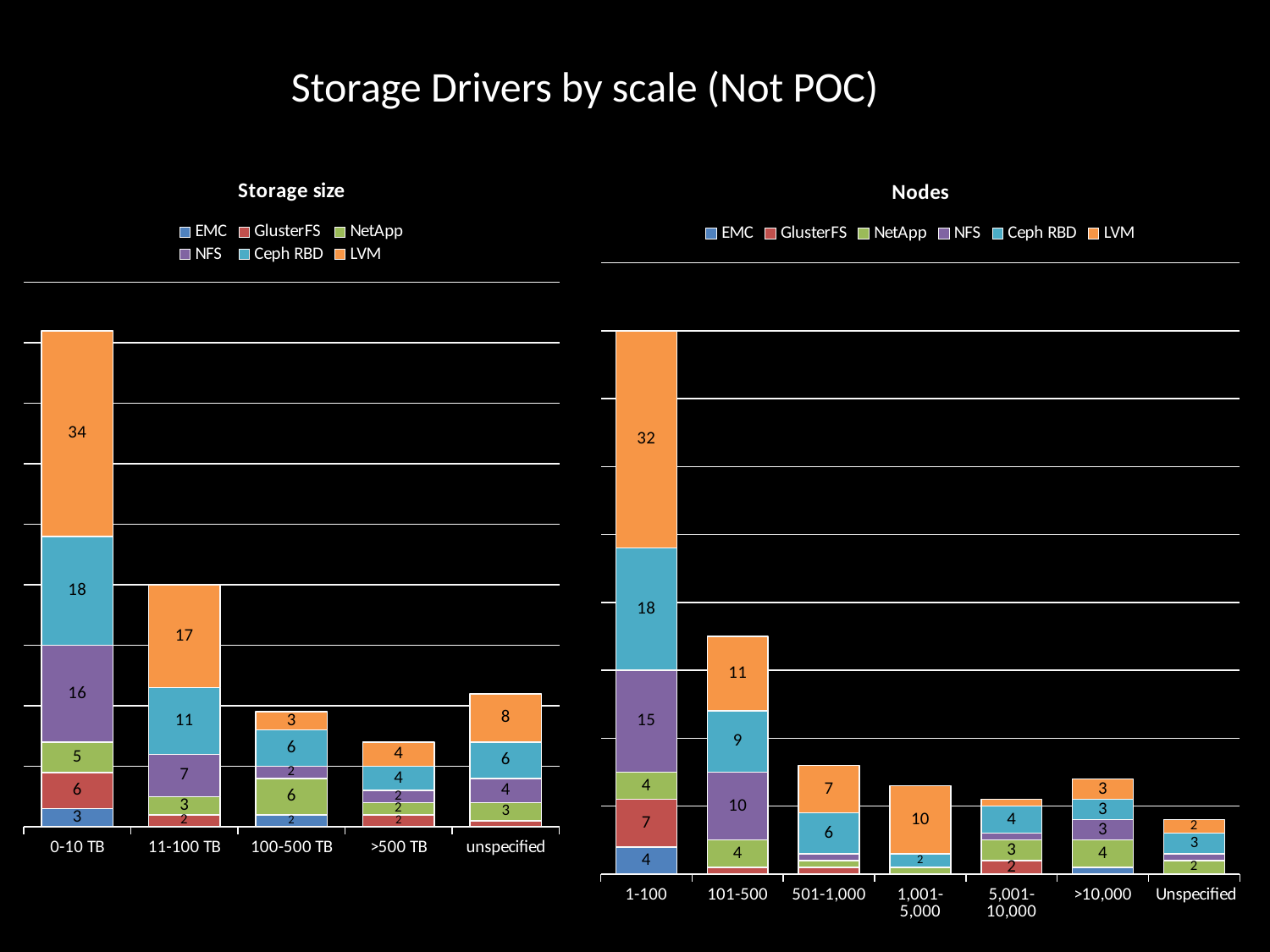
In the Nodes chart, which category has the tallest stacked bar? 1-100 In the Storage size chart, what is the difference between the LVM values for 0-10 TB and 11-100 TB? 17 What type of chart is the Storage size chart? Stacked bar chart In the Nodes chart, what is the NFS value for 1-100 nodes? 15 In the Storage size chart, what is the Ceph RBD value for 11-100 TB? 11 In the Storage size chart, which category has the tallest stacked bar? 0-10 TB How many categories are shown on the x axis of the Nodes chart? 7 In the Nodes chart, what is the LVM value for 1,001-5,000 nodes? 10 How many series does the legend of the Storage size chart list? 6 In the Storage size chart, what is the LVM value for 0-10 TB? 34 In the Nodes chart, what is the difference between the LVM values for 1-100 and 101-500 nodes? 21 In the Nodes chart, which is larger for 101-500 nodes: the NFS value or the Ceph RBD value? NFS